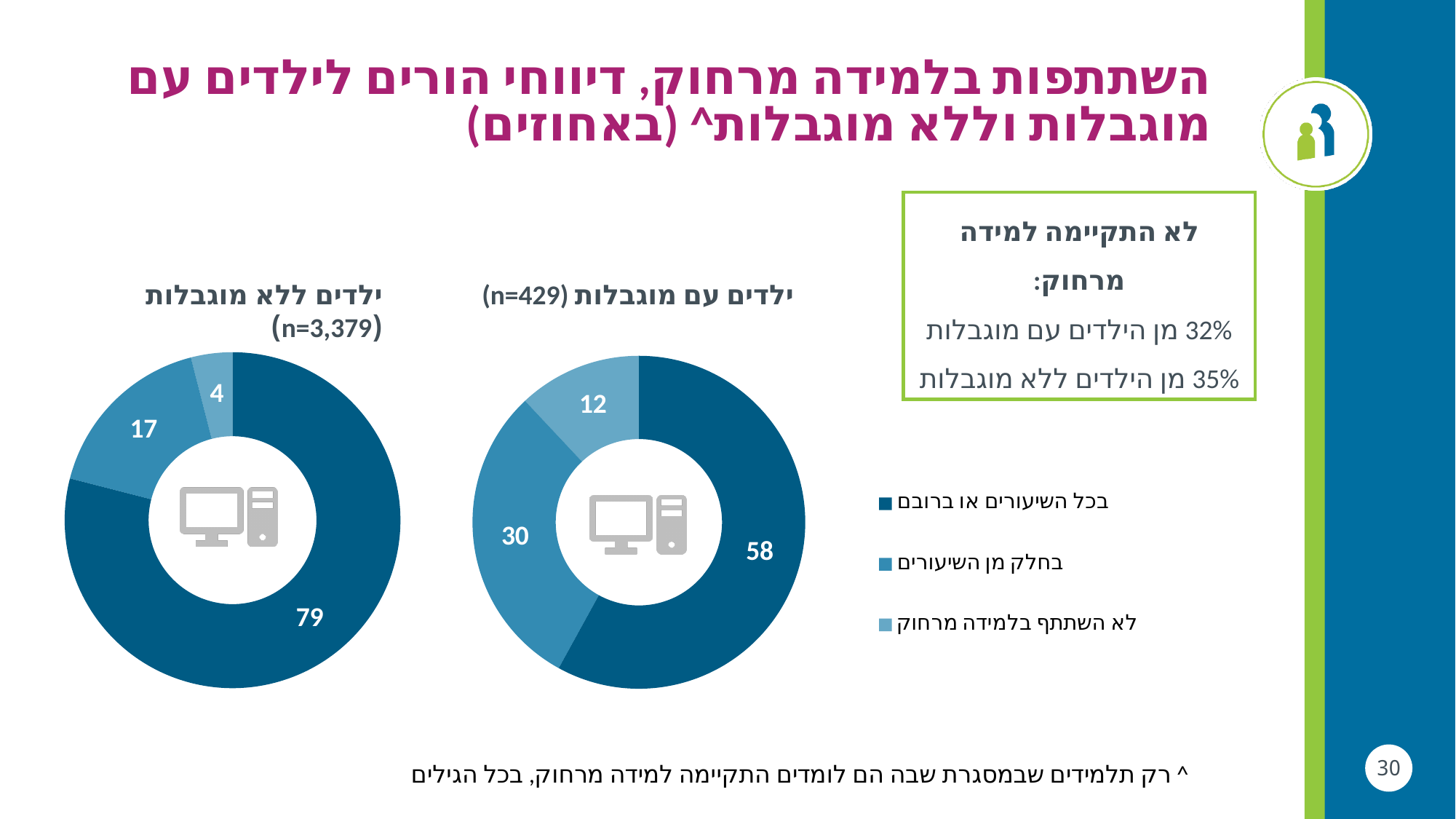
What type of chart is used on this slide? Donut (pie) chart What is the difference between the 'בכל השיעורים או ברובם' value in the 'ילדים ללא מוגבלות' chart and the same category in the 'ילדים עם מוגבלות' chart? 21 In the chart titled 'ילדים ללא מוגבלות (n=3,379)', what is the value for 'בכל השיעורים או ברובם'? 79 In the chart titled 'ילדים עם מוגבלות (n=429)', what is the value for 'בכל השיעורים או ברובם'? 58 In the chart titled 'ילדים עם מוגבלות (n=429)', which category has the smallest slice? לא השתתף בלמידה מרחוק In the chart titled 'ילדים עם מוגבלות (n=429)', what is the value for 'בחלק מן השיעורים'? 30 How many categories does the legend list for the donut charts? 3 In the chart titled 'ילדים ללא מוגבלות (n=3,379)', what is the value for 'לא השתתף בלמידה מרחוק'? 4 Which chart has the larger value for 'בחלק מן השיעורים': 'ילדים עם מוגבלות' or 'ילדים ללא מוגבלות'? ילדים עם מוגבלות How many donut charts are shown on the slide? 2 In the chart titled 'ילדים עם מוגבלות (n=429)', what is the value for 'לא השתתף בלמידה מרחוק'? 12 In the chart titled 'ילדים ללא מוגבלות (n=3,379)', which category has the largest slice? בכל השיעורים או ברובם